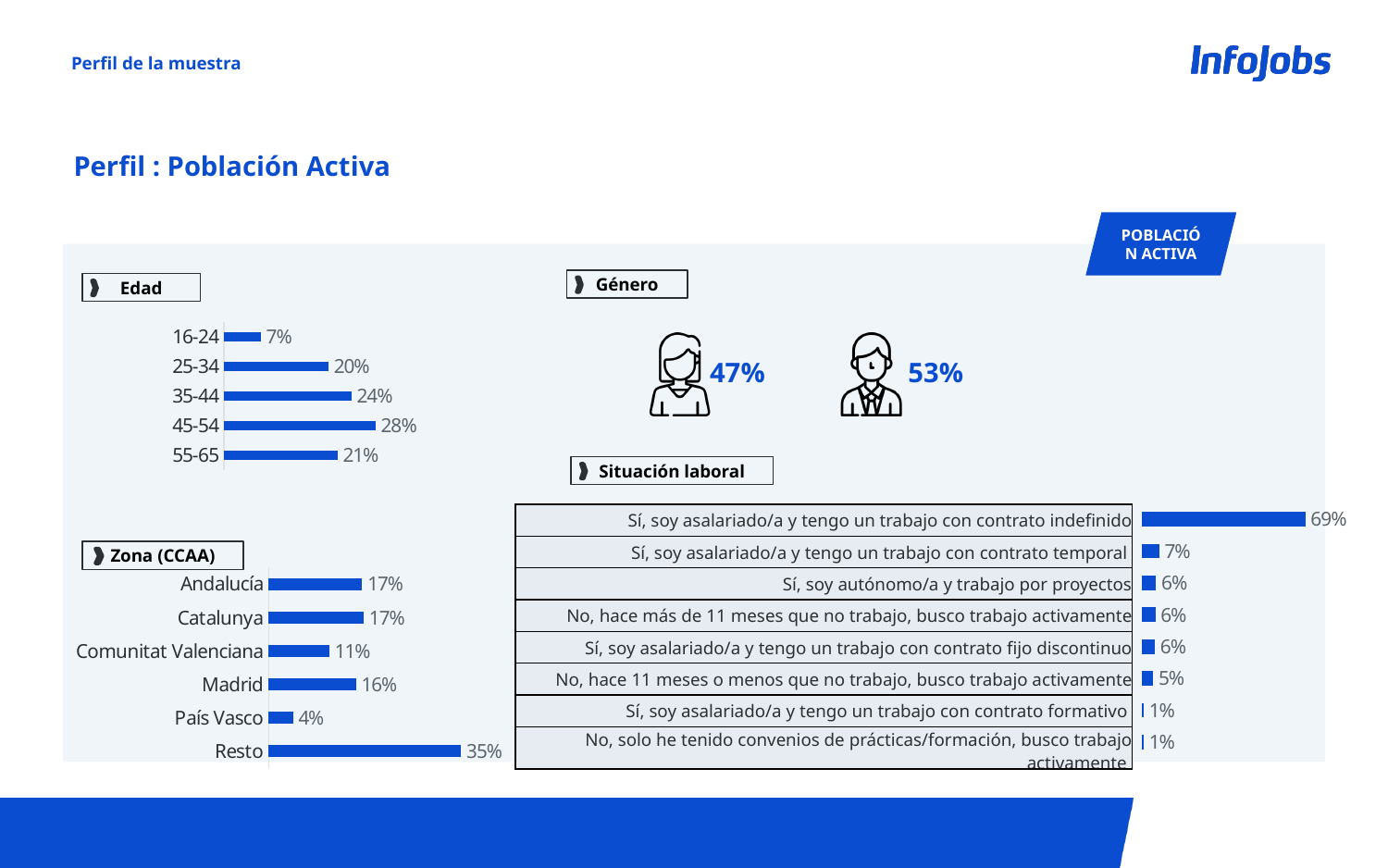
In the Zona (CCAA) chart, which category has the highest value? Resto In the Edad chart, which age group has the highest value? 45-54 In the Edad chart, what is the value for the 45-54 age group? 28% In the Edad chart, which age group has the lowest value? 16-24 In the Situación laboral chart, what is the value for 'Sí, soy asalariado/a y tengo un trabajo con contrato indefinido'? 69% In the Edad chart, what is the difference between the 35-44 and 25-34 values? 4% In the Zona (CCAA) chart, what is the value for País Vasco? 4% In the Zona (CCAA) chart, which is larger, Madrid or Comunitat Valenciana? Madrid How many categories are shown in the Situación laboral chart? 8 How many age groups are shown in the Edad chart? 5 In the Zona (CCAA) chart, what is the difference between Resto and Andalucía? 18% What kind of chart is the Edad chart? Bar chart